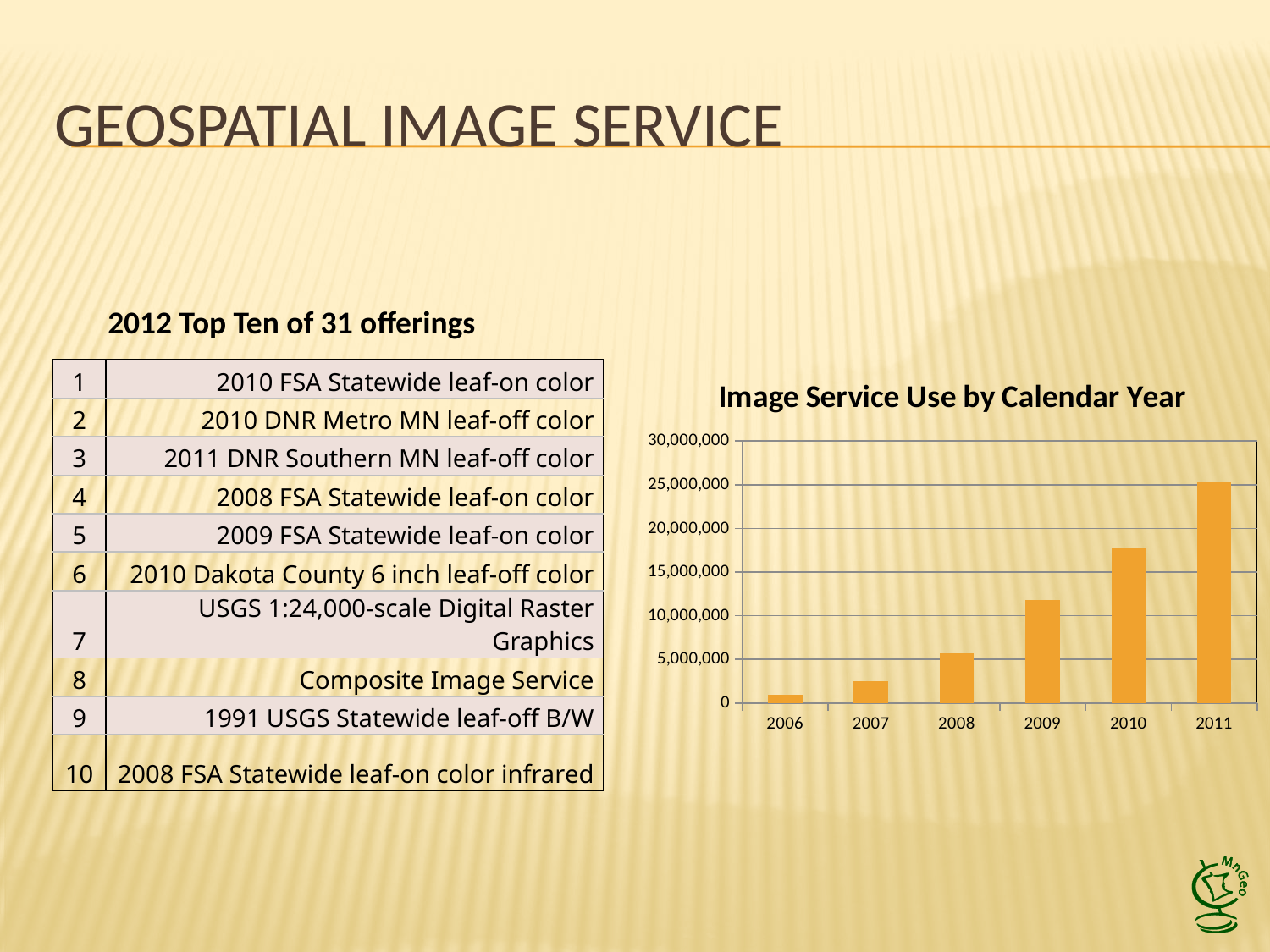
What type of chart is shown on the slide? bar chart Do the values in the chart rise or fall from 2006 to 2011? rise Is the value for 2009 greater or less than 10,000,000? greater Which year has the highest image service use in the chart? 2011 Is the value for 2007 greater or less than 5,000,000? less How many years are shown on the x axis of the chart? 6 What is the title of the chart on the slide? Image Service Use by Calendar Year Is the value for 2011 greater or less than 20,000,000? greater Which year has the lowest image service use in the chart? 2006 Which year has the larger value in the chart, 2009 or 2010? 2010